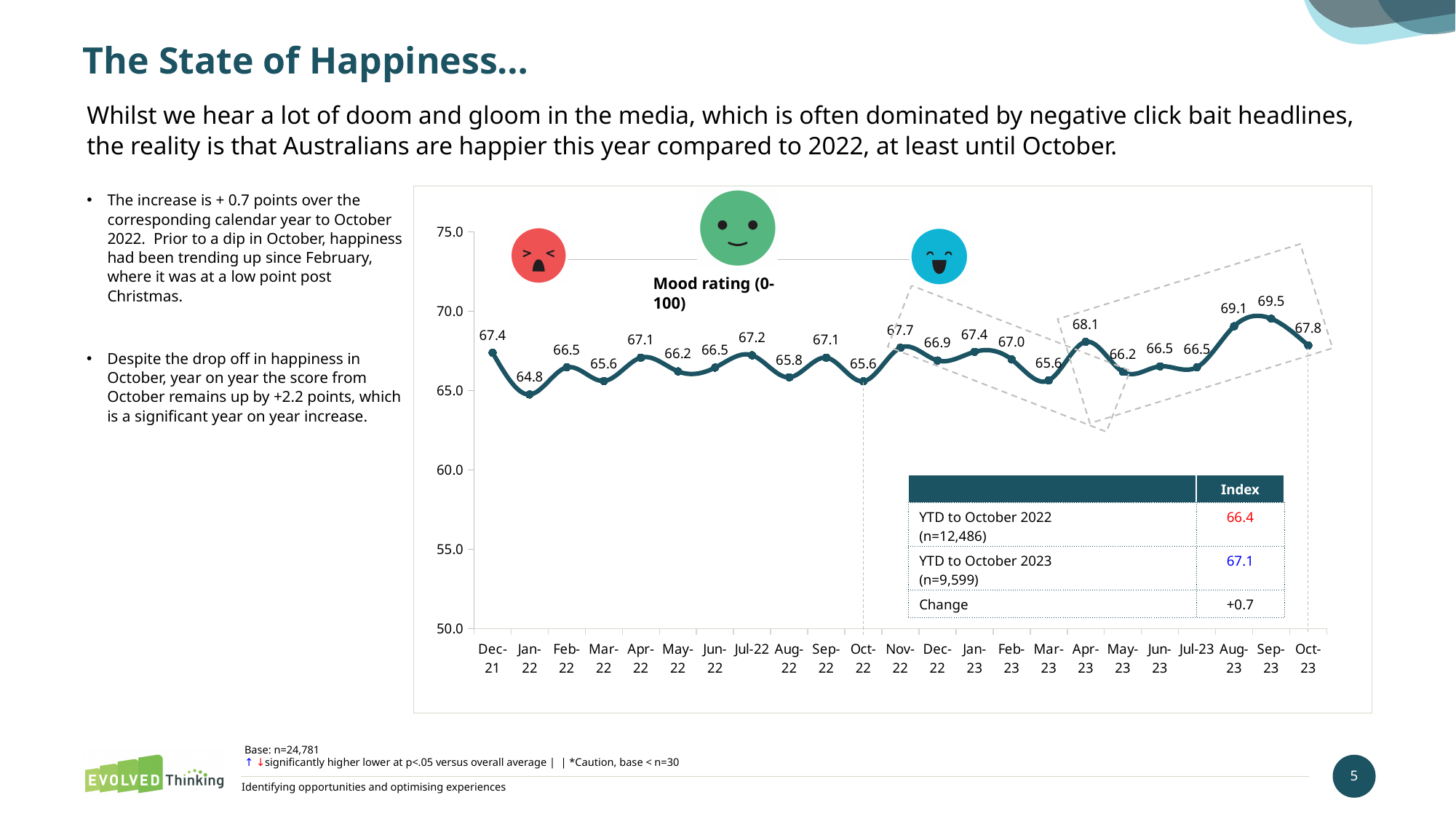
Which is higher, the mood rating for Aug-23 or Aug-22? Aug-23 Which month has the lowest mood rating? Jan-22 What is the mood rating for Jan-22? 64.8 What is the mood rating for Apr-23? 68.1 Which month has the highest mood rating? Sep-23 What is the mood rating for Oct-22? 65.6 What is the mood rating for Sep-23? 69.5 Is the mood rating for Sep-23 greater or less than 70.0? less What is the label shown above the line in the chart? Mood rating (0-100) How many months are plotted on the chart? 23 What is the difference between the mood rating for Oct-23 and Oct-22? 2.2 What kind of chart is shown on the slide? line chart